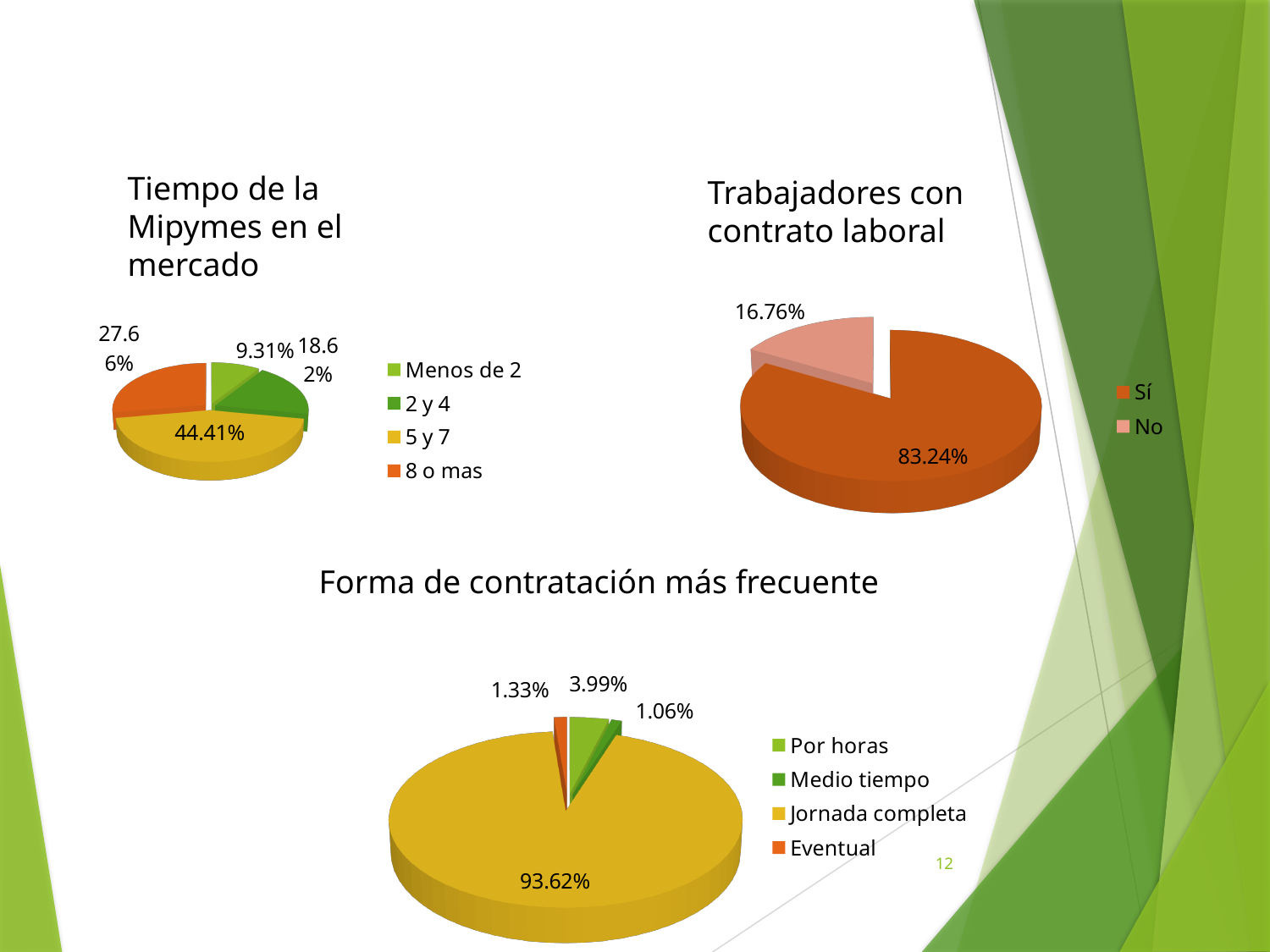
In the 'Trabajadores con contrato laboral' chart, what is the difference between the 'Sí' and 'No' percentages? 66.48% In the 'Forma de contratación más frecuente' chart, which is larger, 'Por horas' or 'Eventual'? Por horas In the 'Tiempo de la Mipymes en el mercado' chart, which category has the smallest share? Menos de 2 How many categories does the legend of the 'Tiempo de la Mipymes en el mercado' chart list? 4 In the 'Forma de contratación más frecuente' chart, what percentage is shown for 'Por horas'? 3.99% In the 'Trabajadores con contrato laboral' chart, what percentage is shown for 'Sí'? 83.24% In the 'Tiempo de la Mipymes en el mercado' chart, which category has the largest share? 5 y 7 In the 'Tiempo de la Mipymes en el mercado' chart, what percentage is shown for 'Menos de 2'? 9.31% What type of chart is the 'Forma de contratación más frecuente' chart? Pie chart In the 'Trabajadores con contrato laboral' chart, what percentage is shown for 'No'? 16.76% In the 'Forma de contratación más frecuente' chart, what percentage is shown for 'Jornada completa'? 93.62% In the 'Tiempo de la Mipymes en el mercado' chart, what percentage is shown for '5 y 7'? 44.41%